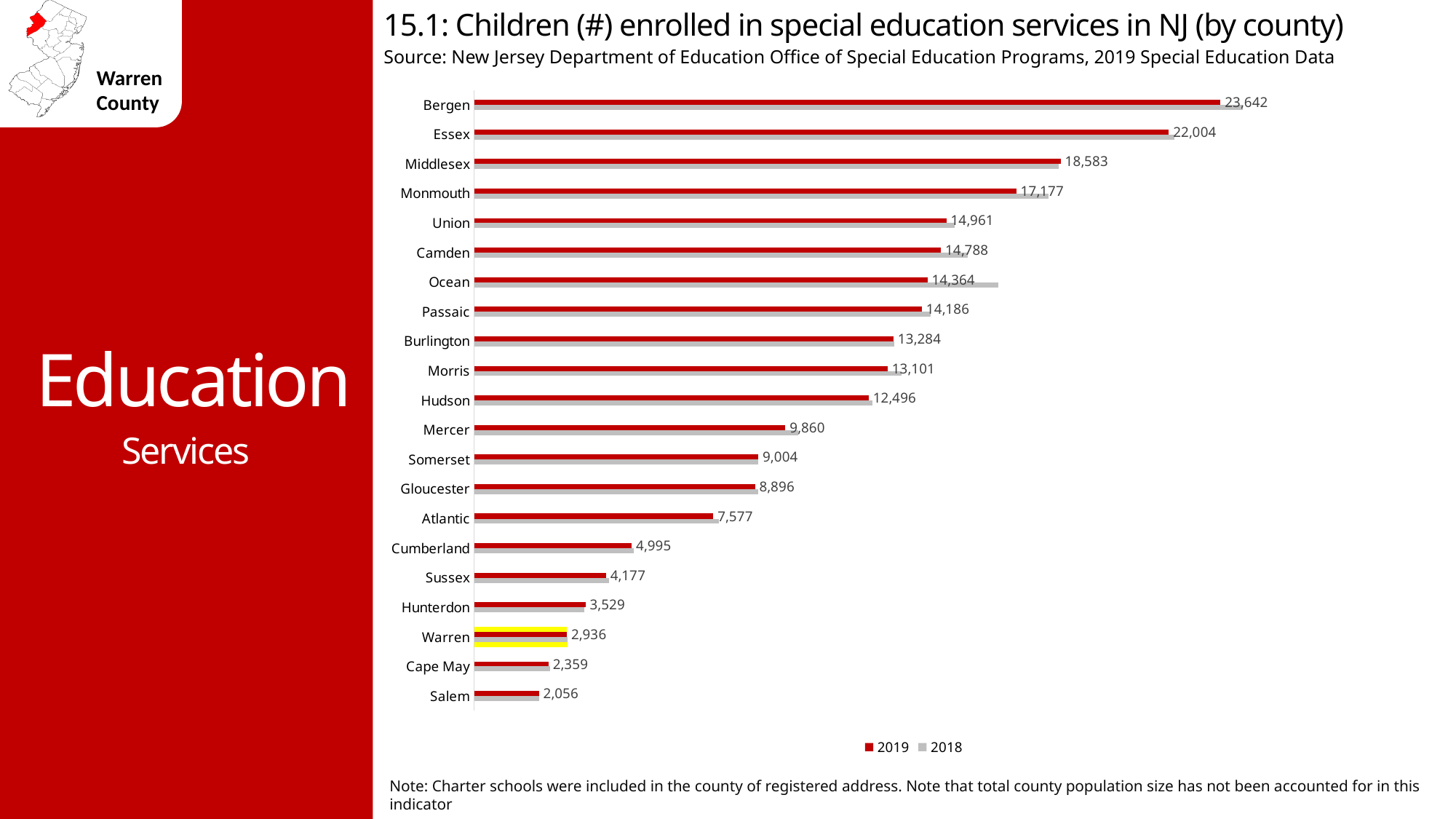
What is the 2019 value for Warren? 2,936 Which county has the highest 2019 value? Bergen Which has the larger 2019 value, Camden or Ocean? Camden How many counties are shown on the chart? 21 What is the difference between the 2019 values for Bergen and Essex? 1,638 Which county's bars are highlighted in yellow? Warren What is the 2019 value for Hudson? 12,496 What is the 2019 value for Bergen? 23,642 Which county has the lowest 2019 value? Salem How many series does the legend list? 2 What kind of chart is shown? Bar chart What is the difference between the 2019 values for Warren and Cape May? 577